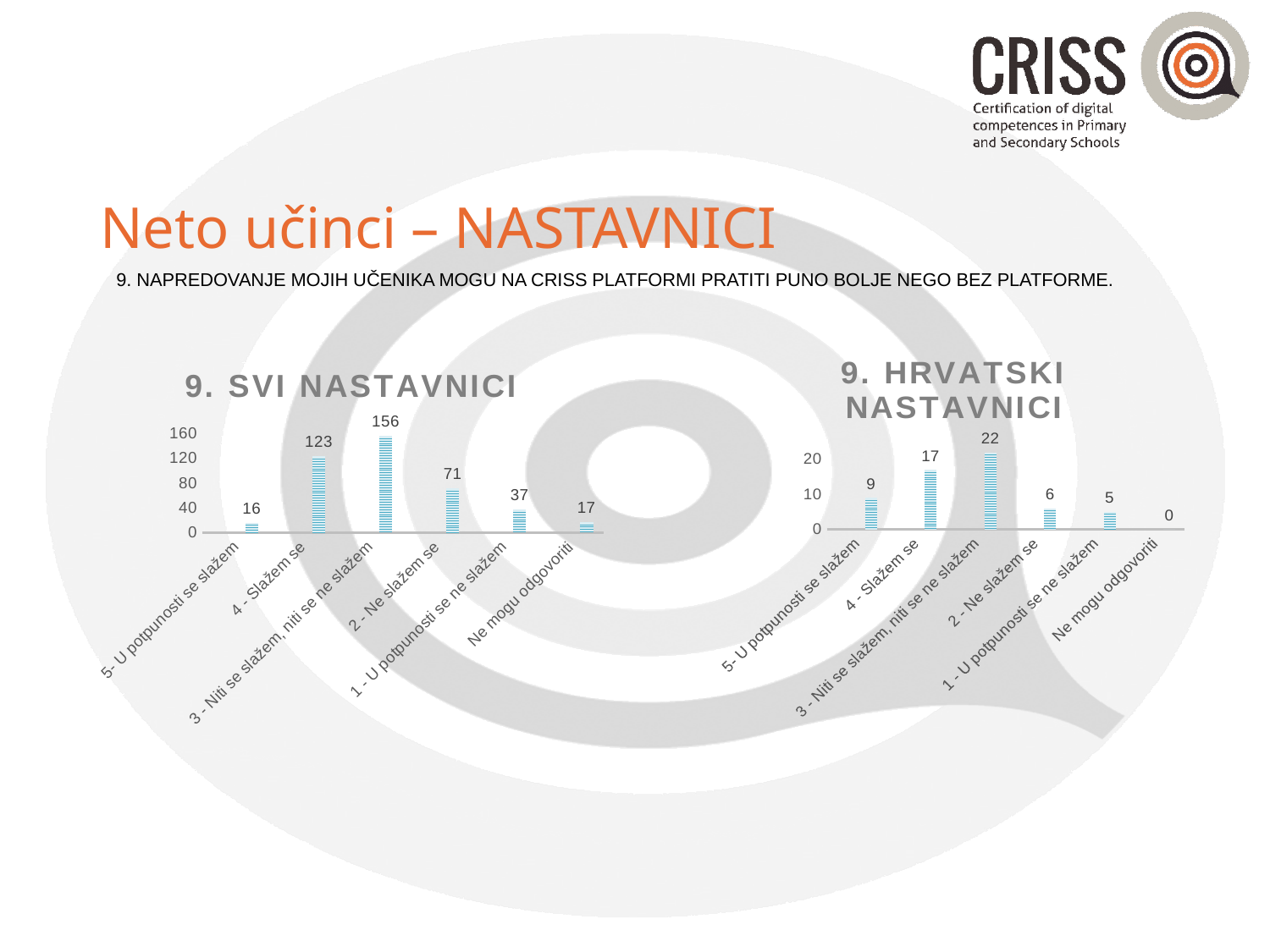
In the '9. SVI NASTAVNICI' chart, which category has the lowest value? 5- U potpunosti se slažem In the '9. HRVATSKI NASTAVNICI' chart, which category has the highest value? 3 - Niti se slažem, niti se ne slažem In the '9. SVI NASTAVNICI' chart, what is the highest value shown on the y axis? 160 In the '9. HRVATSKI NASTAVNICI' chart, what is the value for 'Ne mogu odgovoriti'? 0 In the '9. SVI NASTAVNICI' chart, what is the value for '3 - Niti se slažem, niti se ne slažem'? 156 In the '9. HRVATSKI NASTAVNICI' chart, what is the difference between '3 - Niti se slažem, niti se ne slažem' and '1 - U potpunosti se ne slažem'? 17 What kind of chart is the '9. SVI NASTAVNICI' chart? Bar chart In the '9. HRVATSKI NASTAVNICI' chart, what is the value for '4 - Slažem se'? 17 In the '9. SVI NASTAVNICI' chart, what is the value for 'Ne mogu odgovoriti'? 17 In the '9. SVI NASTAVNICI' chart, how many categories are shown on the x axis? 6 In the '9. HRVATSKI NASTAVNICI' chart, which is larger: '5- U potpunosti se slažem' or '2 - Ne slažem se'? 5- U potpunosti se slažem In the '9. SVI NASTAVNICI' chart, what is the difference between '4 - Slažem se' and '2 - Ne slažem se'? 52